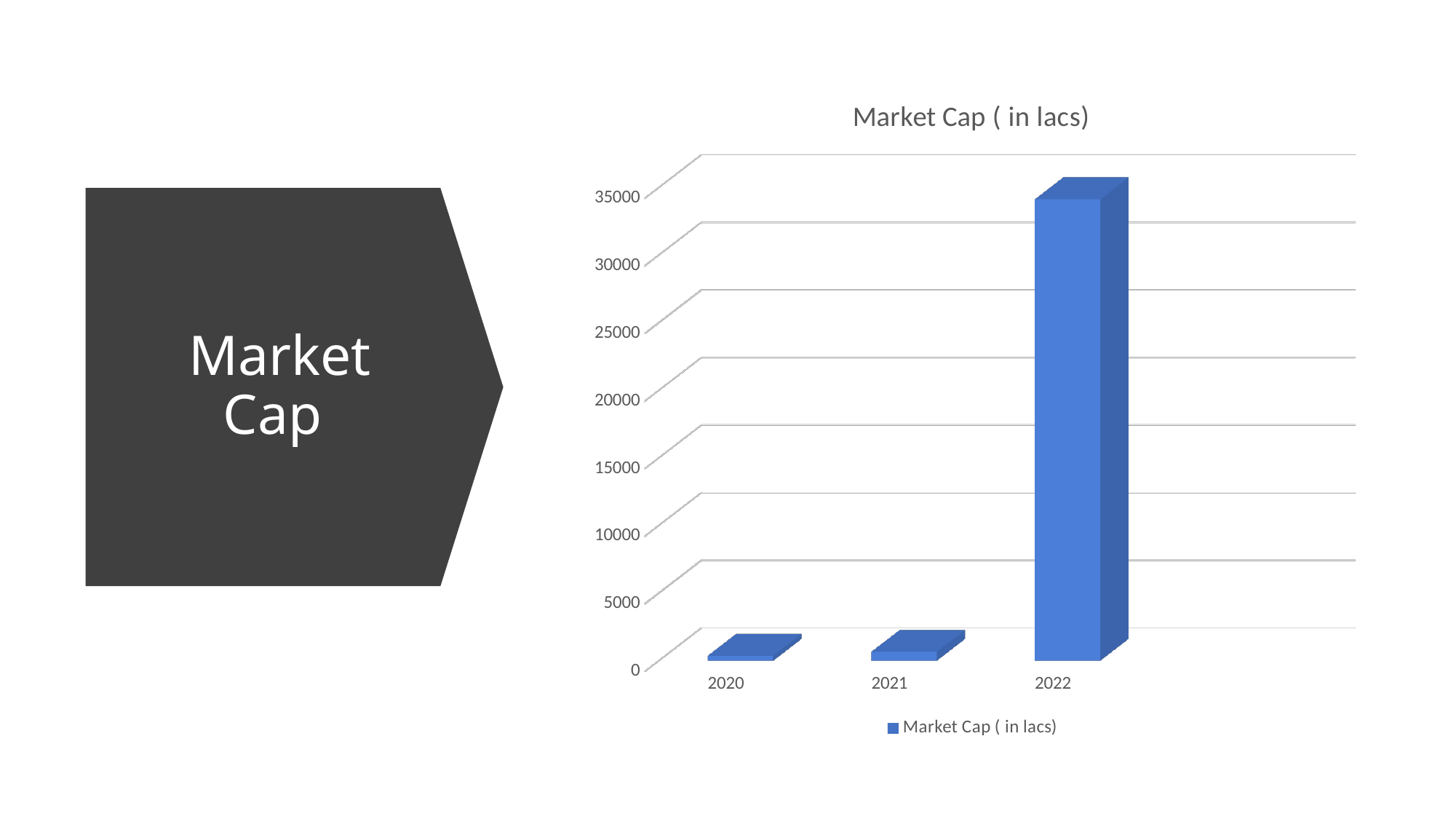
What kind of chart is shown on the slide? bar chart Is the value for 2020 greater or less than 5000? less Is the value for 2022 greater or less than 30000? greater What is the title of the chart? Market Cap ( in lacs) How many years are shown on the x axis of the chart? 3 What is the name of the series shown in the legend? Market Cap ( in lacs) Which is larger, the value for 2021 or the value for 2022? 2022 How many series does the chart legend list? 1 Is the value for 2021 greater or less than 5000? less What is the highest value labelled on the vertical axis? 35000 Which year has the highest market cap? 2022 Do the values generally rise or fall from 2020 to 2022? rise